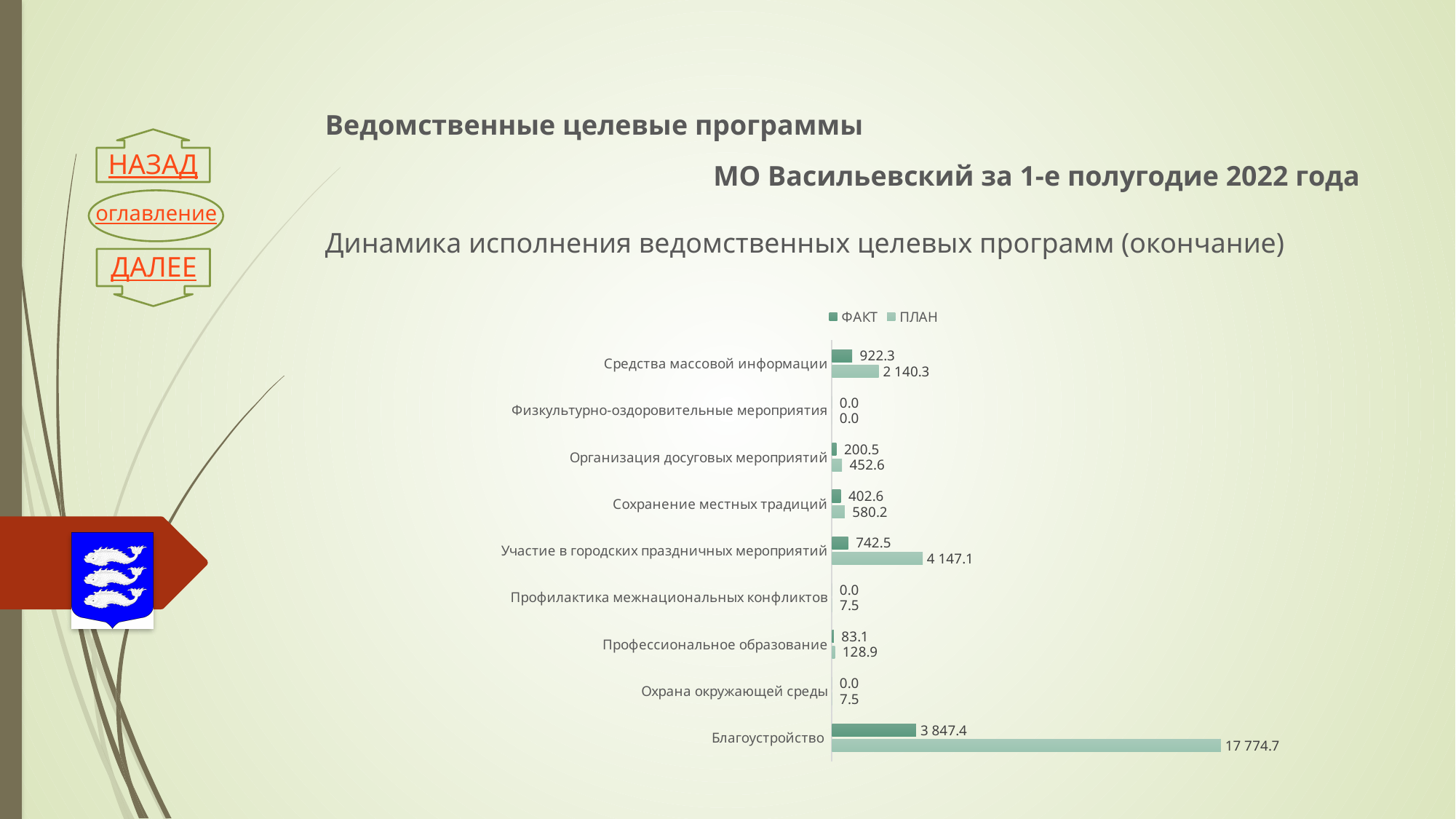
What is the ФАКТ value for Профессиональное образование? 83.1 What kind of chart is shown on the slide? Bar chart What is the difference between the ПЛАН and ФАКТ values for Благоустройство? 13 927.3 What is the ФАКТ value for Благоустройство? 3 847.4 What is the difference between the ПЛАН and ФАКТ values for Сохранение местных традиций? 177.6 Which category has the lowest ПЛАН value? Физкультурно-оздоровительные мероприятия What is the ПЛАН value for Средства массовой информации? 2 140.3 How many categories are shown on the chart? 9 Which is larger: the ФАКТ value for Средства массовой информации or the ФАКТ value for Участие в городских праздничных мероприятиях? Средства массовой информации How many series does the legend list? 2 Which category has the highest ПЛАН value? Благоустройство What is the ПЛАН value for Участие в городских праздничных мероприятиях? 4 147.1